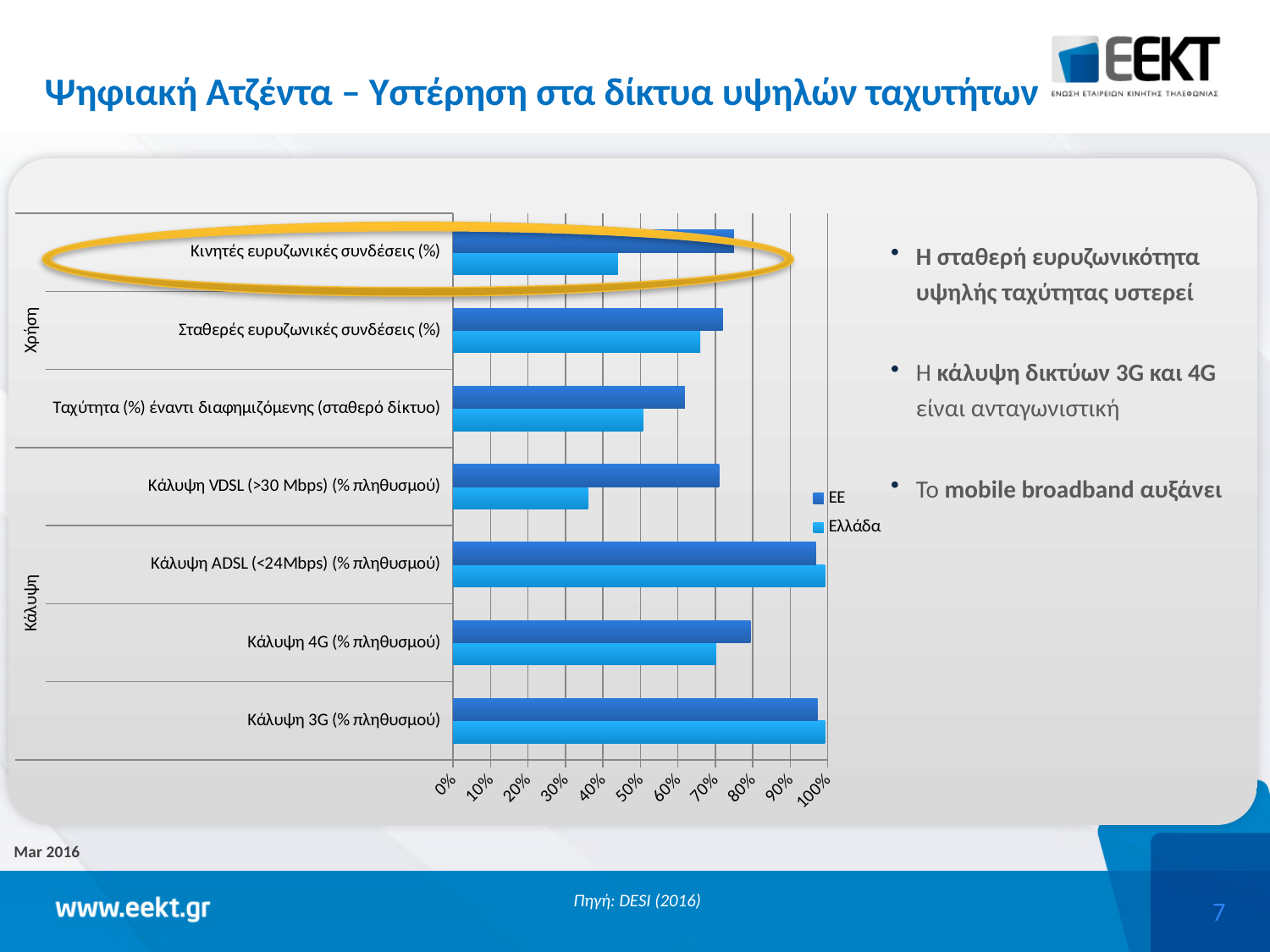
Is the ΕΕ value for Κάλυψη 3G (% πληθυσμού) greater or less than 90%? greater How many categories are plotted on the chart? 7 Is the Ελλάδα value for Κάλυψη VDSL (>30 Mbps) (% πληθυσμού) greater or less than 40%? less Which category has the lowest Ελλάδα value? Κάλυψη VDSL (>30 Mbps) (% πληθυσμού) Is the Ελλάδα value for Κάλυψη 4G (% πληθυσμού) greater or less than 60%? greater For Κινητές ευρυζωνικές συνδέσεις (%), which is larger, the ΕΕ value or the Ελλάδα value? ΕΕ For Κάλυψη VDSL (>30 Mbps) (% πληθυσμού), which is larger, the ΕΕ value or the Ελλάδα value? ΕΕ Which series does the legend list first? ΕΕ How many series does the chart legend list? 2 What kind of chart is shown on the slide? bar chart